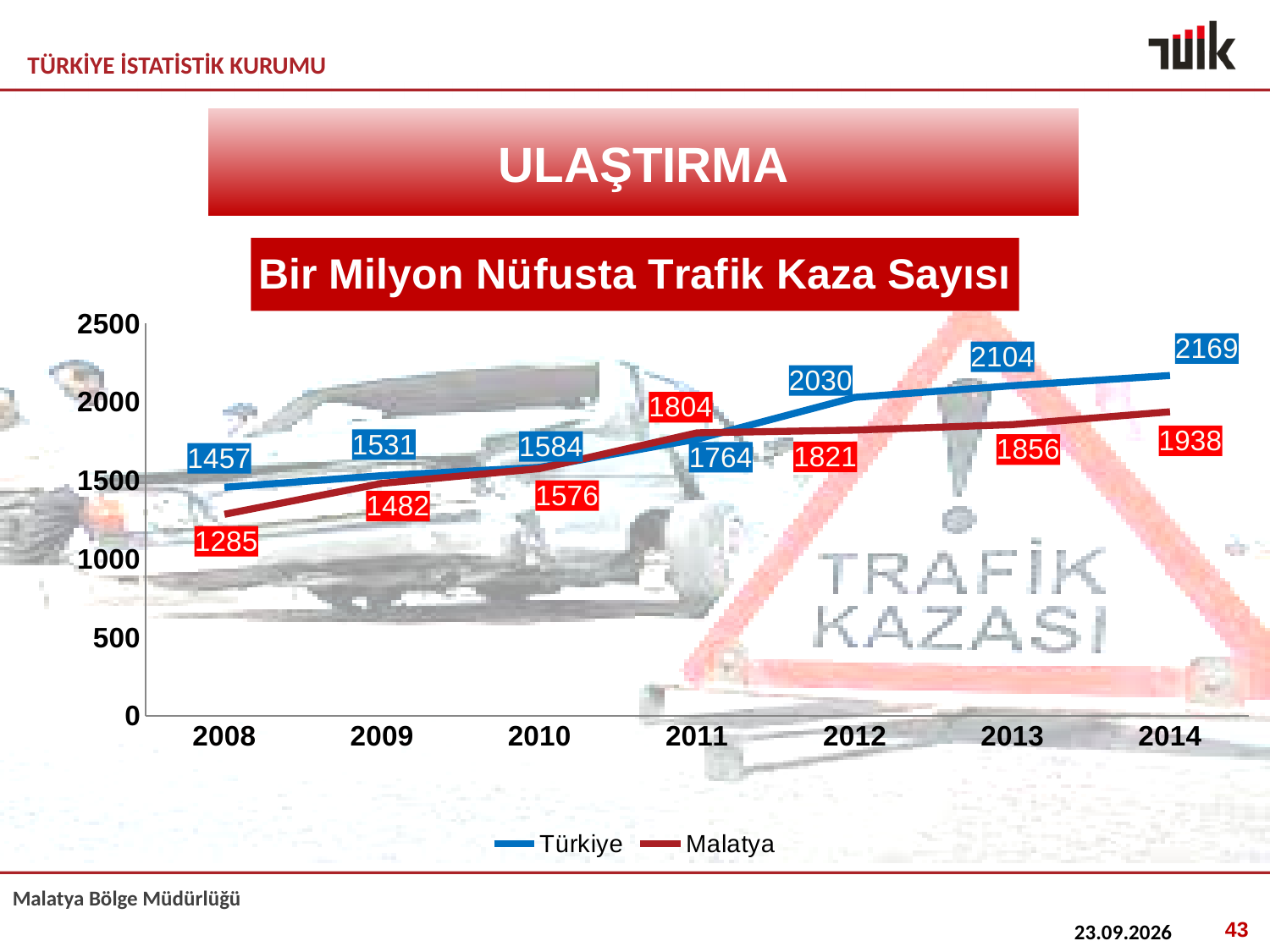
Is the value for Türkiye in 2013 greater or less than 2000? greater What is the value for Malatya in 2011? 1804 What is the value for Türkiye in 2012? 2030 What kind of chart is shown on the slide? Line chart What is the value for Türkiye in 2014? 2169 What is the difference between the Türkiye and Malatya values in 2014? 231 How many years are shown on the x axis? 7 In which year is the Türkiye series highest? 2014 What is the value for Malatya in 2008? 1285 How many series does the legend list? 2 In which year is the Malatya series lowest? 2008 In 2011, which series has the larger value, Türkiye or Malatya? Malatya